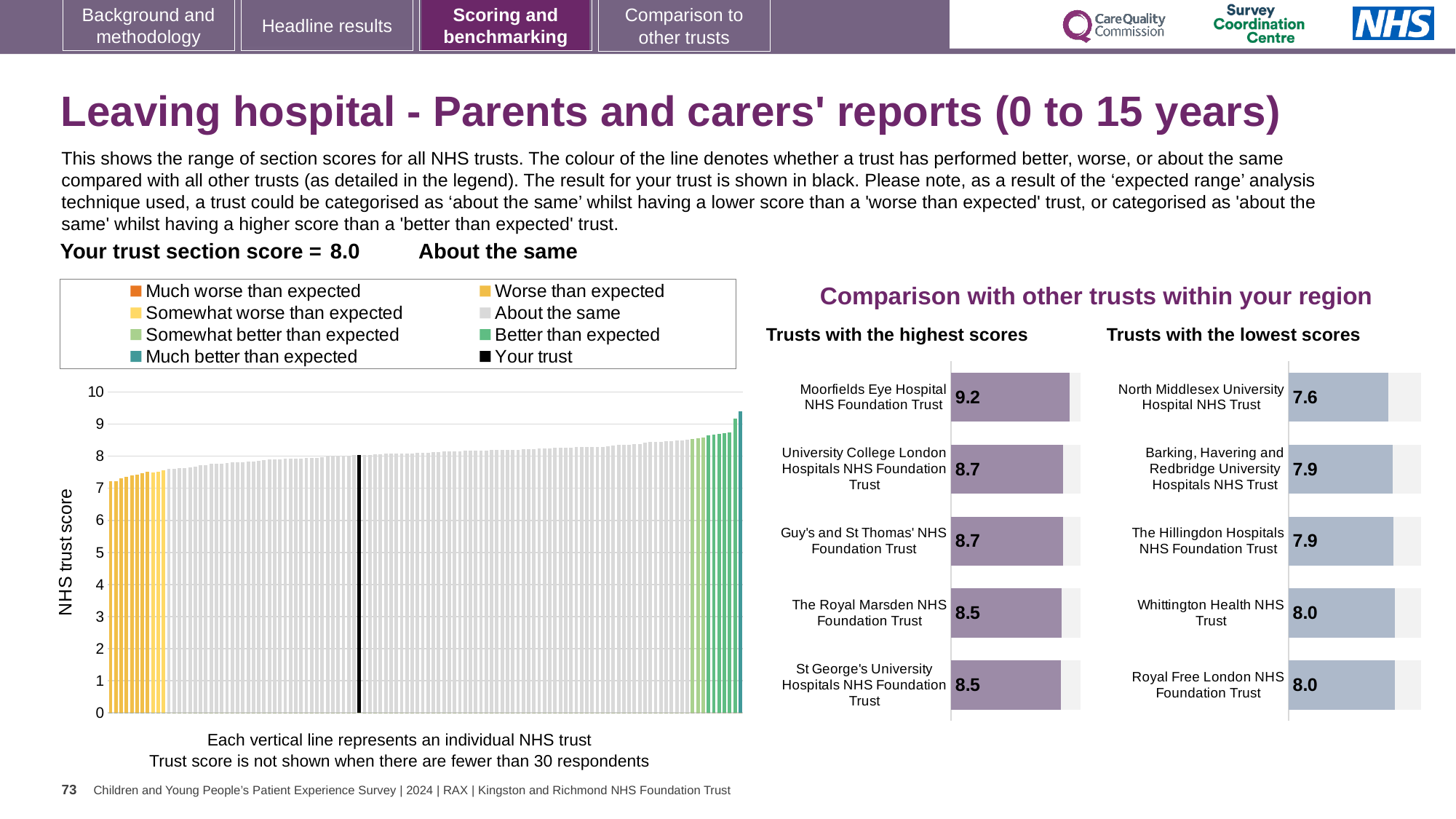
In the main NHS trust score chart on the left, what is the section score for your trust (the black line)? 8.0 In the main NHS trust score chart on the left, is the value of the rightmost bar greater or less than 9? greater How many entries does the legend above the main NHS trust score chart list? 8 What is the difference between the score for Moorfields Eye Hospital NHS Foundation Trust in the highest scores chart and the score for North Middlesex University Hospital NHS Trust in the lowest scores chart? 1.6 In the 'Trusts with the lowest scores' chart, which trust has the lowest score? North Middlesex University Hospital NHS Trust In the 'Trusts with the highest scores' chart, which trust has the highest score? Moorfields Eye Hospital NHS Foundation Trust In the 'Trusts with the highest scores' chart, how many trusts are shown? 5 In the 'Trusts with the lowest scores' chart, what is the score for North Middlesex University Hospital NHS Trust? 7.6 In the 'Trusts with the lowest scores' chart, what is the score for The Hillingdon Hospitals NHS Foundation Trust? 7.9 In the 'Trusts with the highest scores' chart, what is the score for Moorfields Eye Hospital NHS Foundation Trust? 9.2 Which has the larger score: The Royal Marsden NHS Foundation Trust in the highest scores chart or Whittington Health NHS Trust in the lowest scores chart? The Royal Marsden NHS Foundation Trust In the main NHS trust score chart on the left, do the values rise or fall from left to right? rise